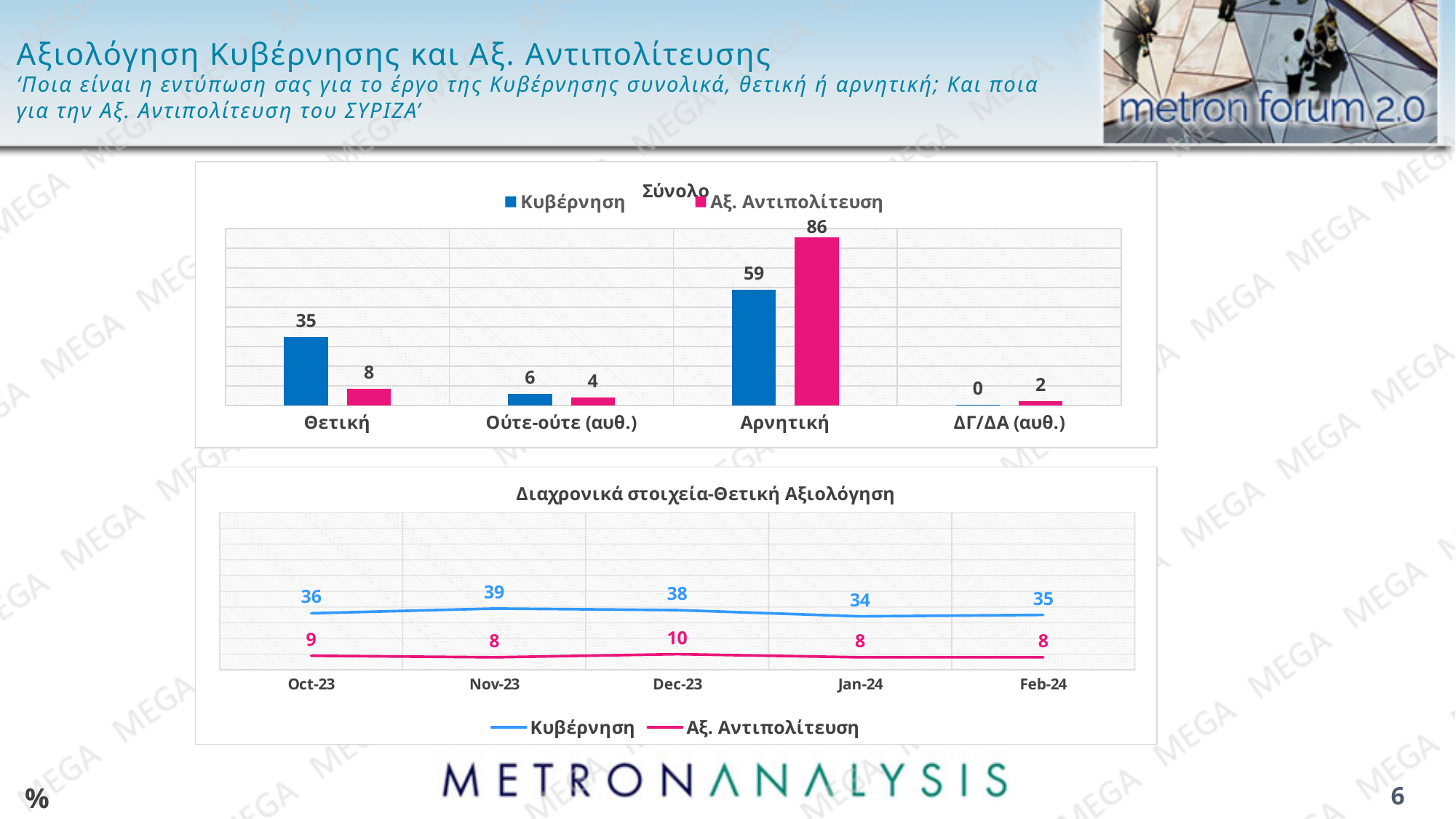
What kind of chart is the top chart (Σύνολο)? Bar chart In the top chart (Σύνολο), what is the difference between Αξ. Αντιπολίτευση and Κυβέρνηση in the Αρνητική category? 27 In the bottom chart (Διαχρονικά στοιχεία-Θετική Αξιολόγηση), how many series does the legend list? 2 In the top chart (Σύνολο), which is larger in the Θετική category: Κυβέρνηση or Αξ. Αντιπολίτευση? Κυβέρνηση In the top chart (Σύνολο), how many categories are shown on the x axis? 4 In the bottom chart (Διαχρονικά στοιχεία-Θετική Αξιολόγηση), in which month is the Κυβέρνηση value lowest? Jan-24 In the top chart (Σύνολο), what is the value for Αξ. Αντιπολίτευση in the Αρνητική category? 86 In the top chart (Σύνολο), what is the value for Κυβέρνηση in the Θετική category? 35 In the bottom chart (Διαχρονικά στοιχεία-Θετική Αξιολόγηση), what is the difference between Κυβέρνηση and Αξ. Αντιπολίτευση in Feb-24? 27 In the bottom chart (Διαχρονικά στοιχεία-Θετική Αξιολόγηση), what is the value for Αξ. Αντιπολίτευση in Dec-23? 10 In the top chart (Σύνολο), which category has the highest value for Κυβέρνηση? Αρνητική In the bottom chart (Διαχρονικά στοιχεία-Θετική Αξιολόγηση), what is the value for Κυβέρνηση in Nov-23? 39